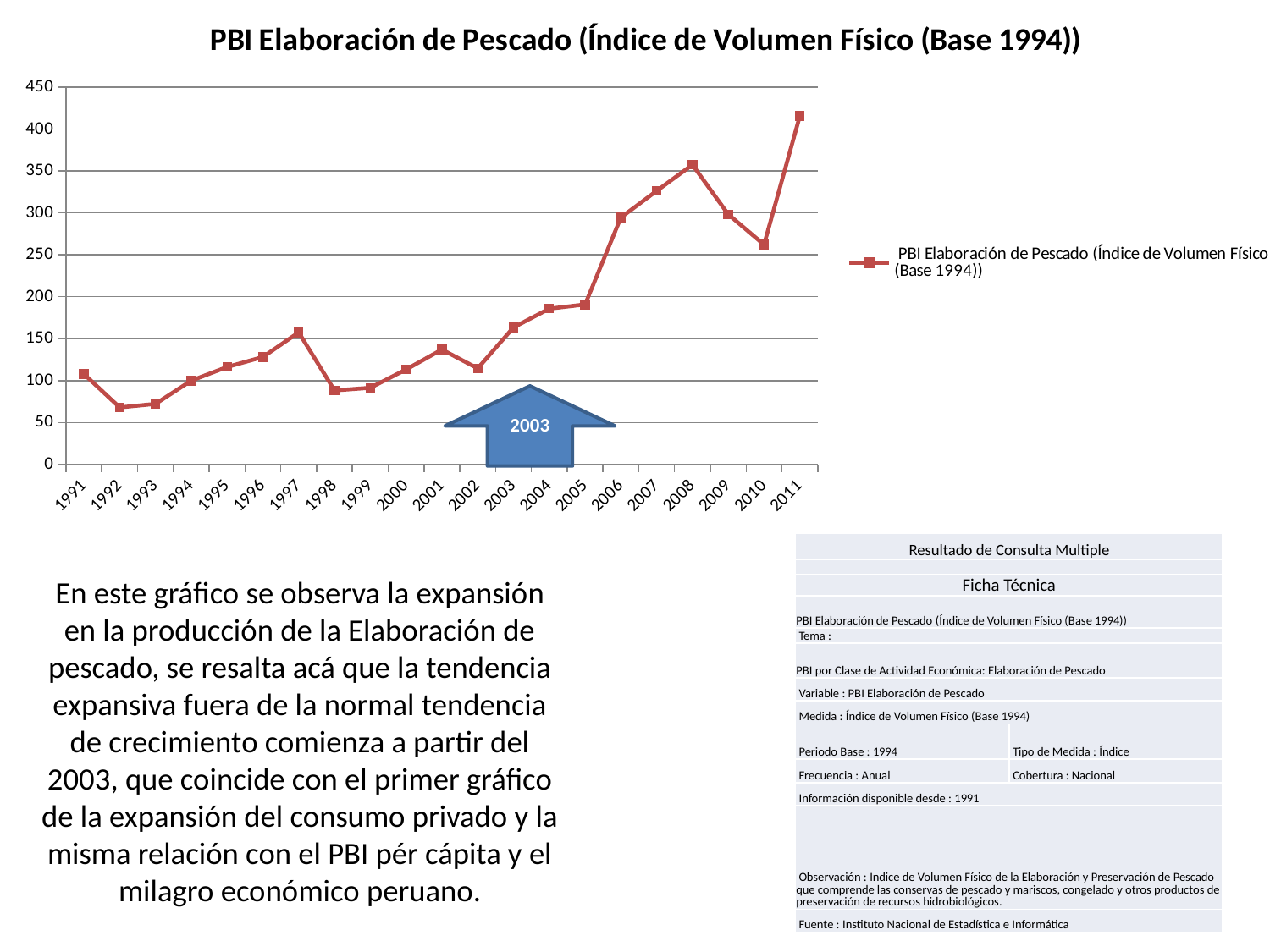
Is the value for 2011 greater or less than 400? greater Which year has the larger value, 2008 or 2009? 2008 Overall, do the values rise or fall from 1991 to 2011? rise Is the value for 1992 greater or less than 100? less What kind of chart is shown on the slide? line chart How many years are plotted along the x axis of the chart? 21 Is the value for 2010 greater or less than 250? greater Which year has the highest value in the chart? 2011 Which year has the larger value, 1997 or 1998? 1997 How many series does the chart's legend list? 1 What year is written inside the arrow shape on the chart? 2003